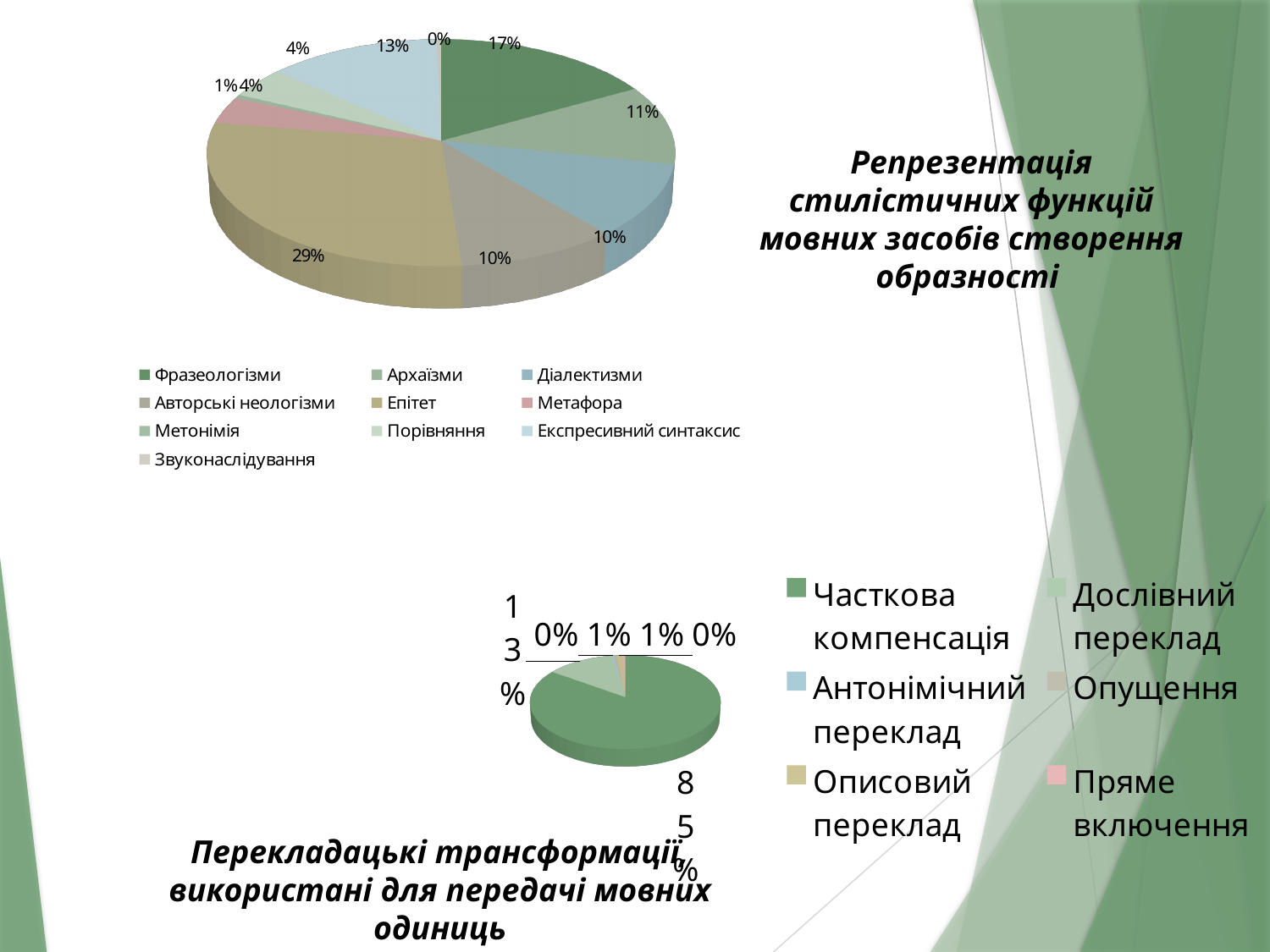
What type of chart is the top chart 'Репрезентація стилістичних функцій мовних засобів створення образності'? Pie chart In the top chart 'Репрезентація стилістичних функцій мовних засобів створення образності', which category has the largest share? Епітет In the bottom chart 'Перекладацькі трансформації використані для передачі мовних одиниць', what percentage is shown for Дослівний переклад? 13% In the top chart 'Репрезентація стилістичних функцій мовних засобів створення образності', what percentage is shown for Експресивний синтаксис? 13% In the bottom chart 'Перекладацькі трансформації використані для передачі мовних одиниць', which category has the largest share? Часткова компенсація In the bottom chart 'Перекладацькі трансформації використані для передачі мовних одиниць', what percentage is shown for Часткова компенсація? 85% In the top chart 'Репрезентація стилістичних функцій мовних засобів створення образності', what percentage is shown for Епітет? 29% In the top chart 'Репрезентація стилістичних функцій мовних засобів створення образності', what percentage is shown for Фразеологізми? 17% In the top chart 'Репрезентація стилістичних функцій мовних засобів створення образності', which is larger: Архаїзми or Експресивний синтаксис? Експресивний синтаксис How many categories does the legend of the top chart 'Репрезентація стилістичних функцій мовних засобів створення образності' list? 10 In the top chart 'Репрезентація стилістичних функцій мовних засобів створення образності', what is the difference in percentage points between Епітет and Фразеологізми? 12 How many categories does the legend of the bottom chart 'Перекладацькі трансформації використані для передачі мовних одиниць' list? 6